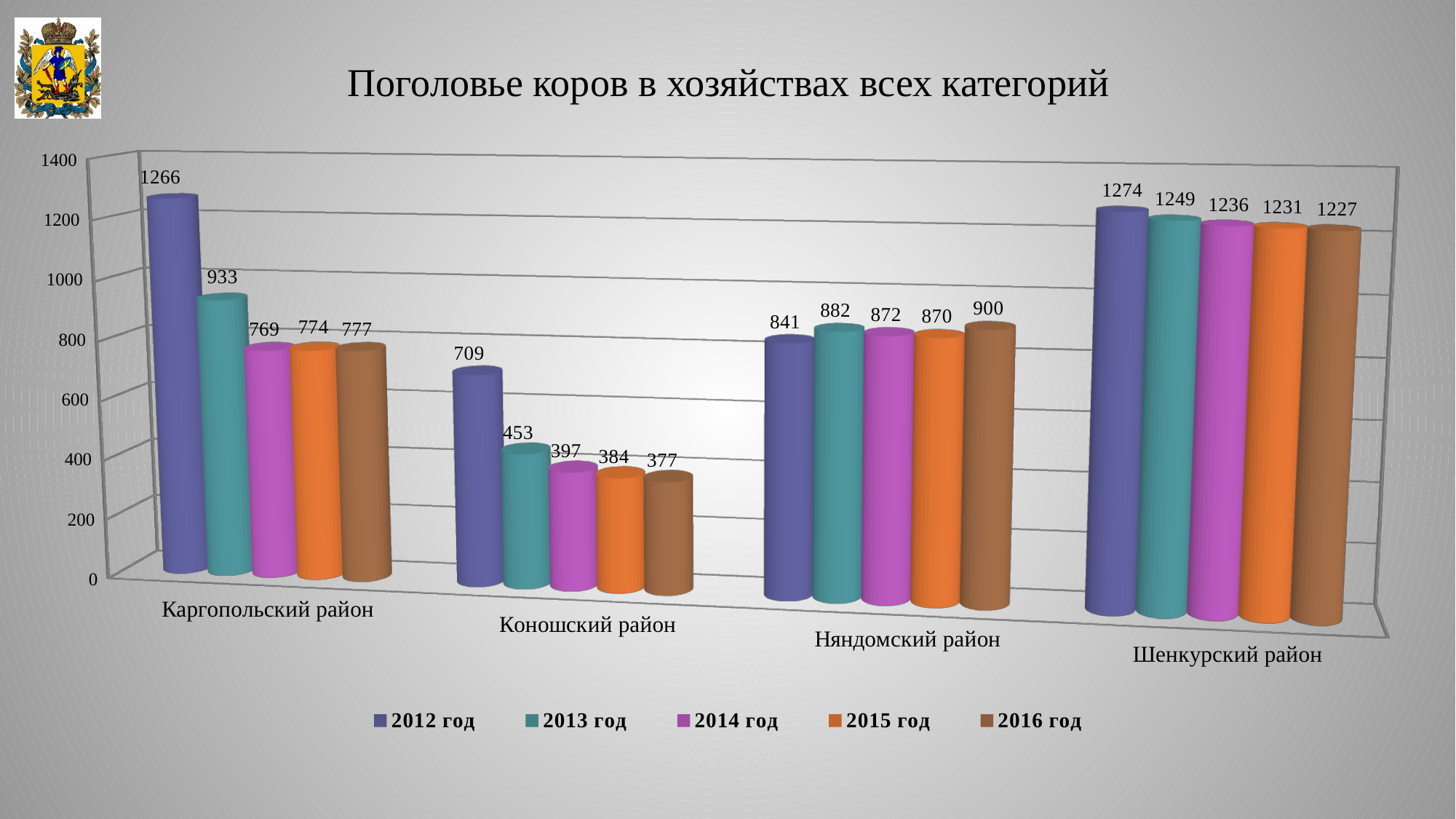
Is the value for Няндомский район in 2012 год greater or less than 800? greater What is the value for Няндомский район in 2016 год? 900 What is the value for Шенкурский район in 2014 год? 1236 Which district has the highest value in 2013 год? Шенкурский район What is the value for Коношский район in 2012 год? 709 Which is larger: the 2012 год value for Каргопольский район or the 2012 год value for Шенкурский район? Шенкурский район Do the values for Коношский район rise or fall from 2012 год to 2016 год? fall How many series does the legend list? 5 How many districts are shown on the x axis? 4 What is the difference between the 2012 год and 2013 год values for Каргопольский район? 333 Which district has the lowest value in 2016 год? Коношский район What kind of chart is shown on the slide? bar chart